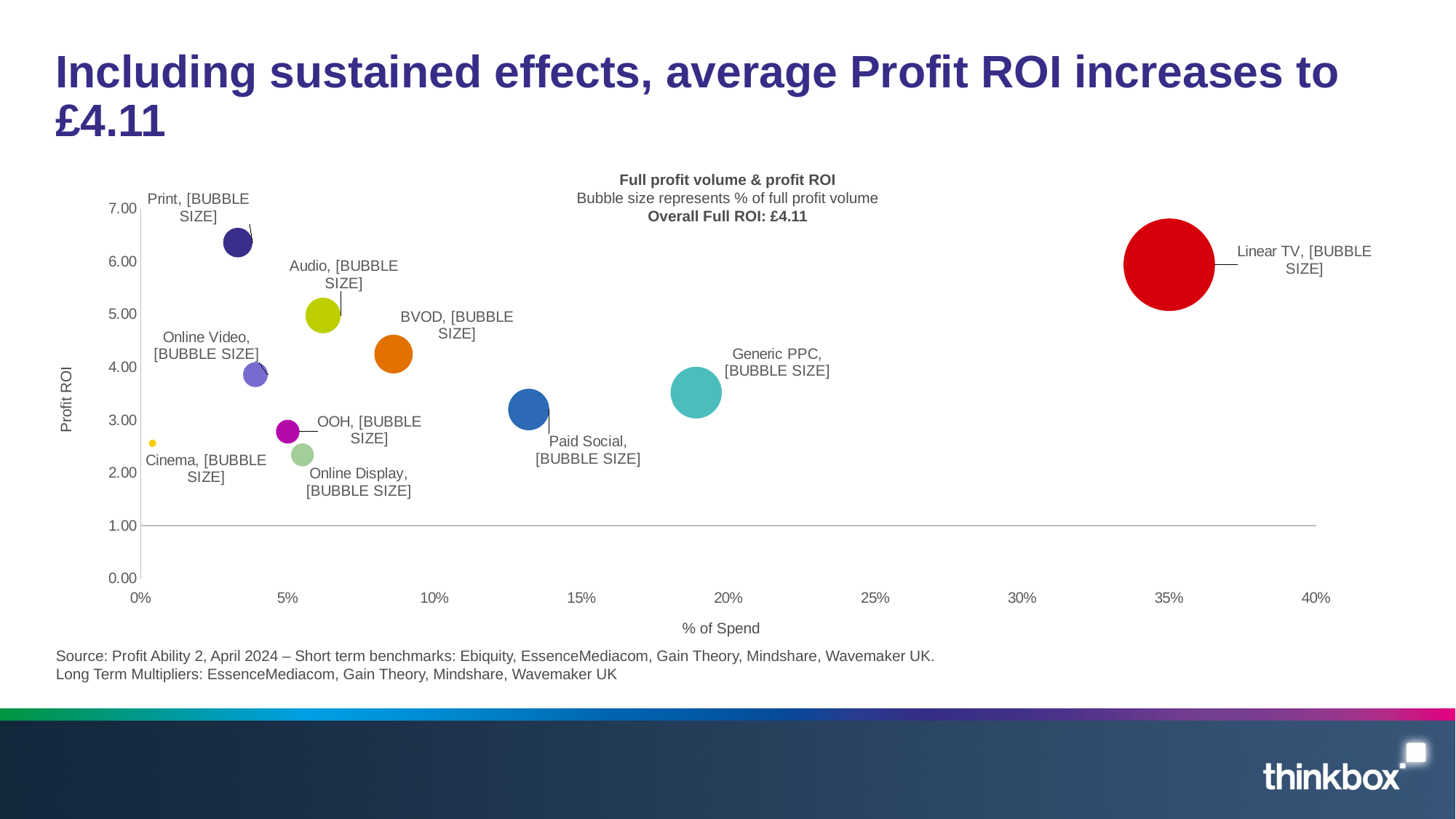
Which channel has the lowest % of spend? Cinema What kind of chart is shown on the slide? Bubble chart Is the Profit ROI for Paid Social greater or less than 4.00? less Is the Profit ROI for Online Display greater or less than 3.00? less Is the Profit ROI for Audio greater or less than 4.00? greater Which channel has the largest bubble (largest share of full profit volume)? Linear TV According to the chart subtitle, what is the Overall Full ROI? £4.11 How many media channels (bubbles) are plotted on the chart? 10 Which has the higher % of spend, Generic PPC or Paid Social? Generic PPC Which has the higher Profit ROI, Audio or BVOD? Audio Which channel has the highest % of spend? Linear TV